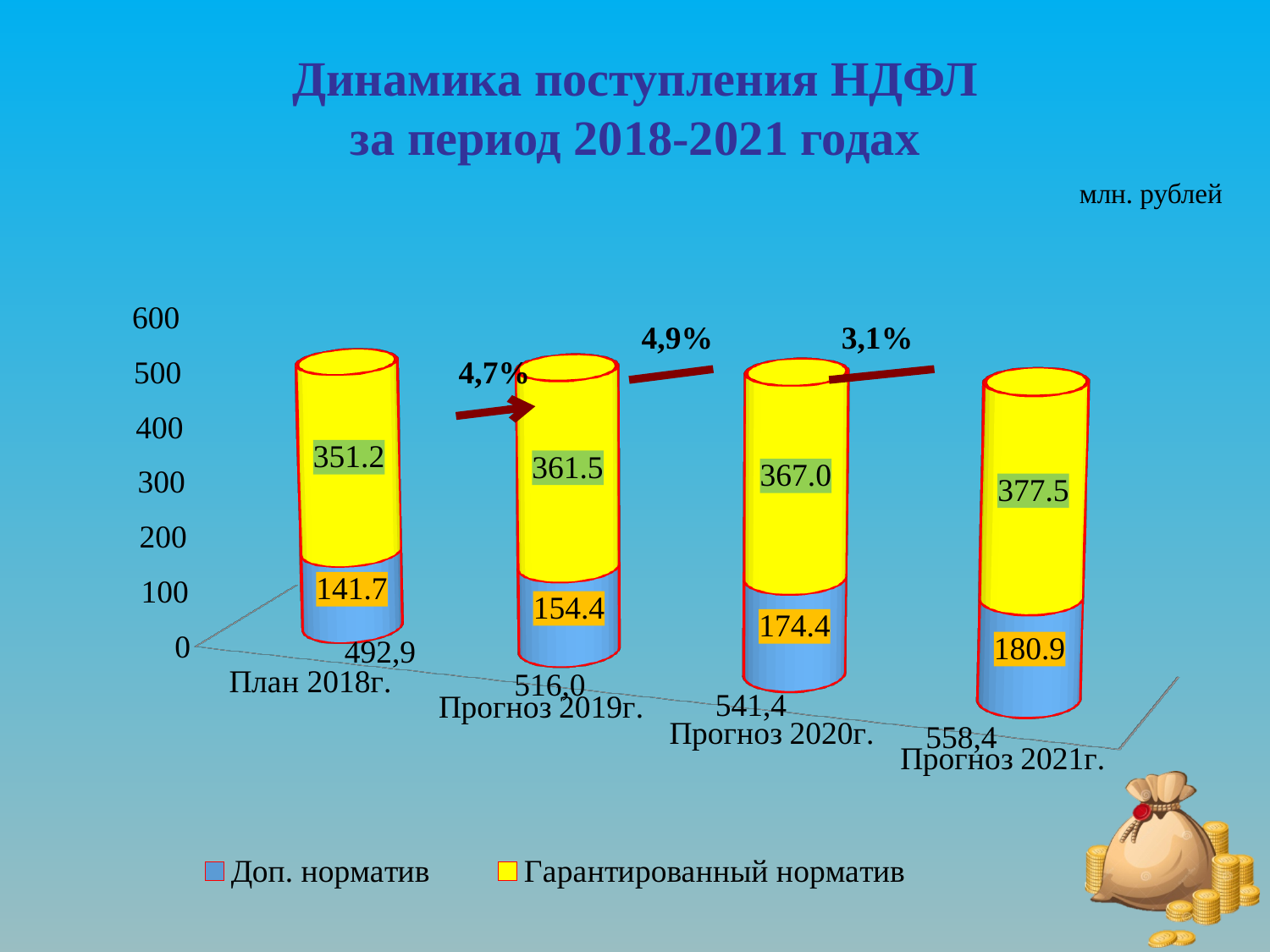
Do the Доп. норматив values rise or fall from План 2018г. to Прогноз 2021г.? rise What is the total of the stacked bar for Прогноз 2021г.? 558,4 What is the value of Доп. норматив for Прогноз 2021г.? 180.9 Which is larger: Доп. норматив for Прогноз 2019г. or Доп. норматив for Прогноз 2020г.? Прогноз 2020г. Which category has the lowest value for Доп. норматив? План 2018г. What is the total of the stacked bar for Прогноз 2019г.? 516,0 What is the difference between the Гарантированный норматив values for Прогноз 2021г. and План 2018г.? 26.3 How many categories are shown on the x axis? 4 How many series does the legend list? 2 What is the value of Доп. норматив for Прогноз 2020г.? 174.4 What is the value of Гарантированный норматив for План 2018г.? 351.2 Which category has the highest value for Гарантированный норматив? Прогноз 2021г.